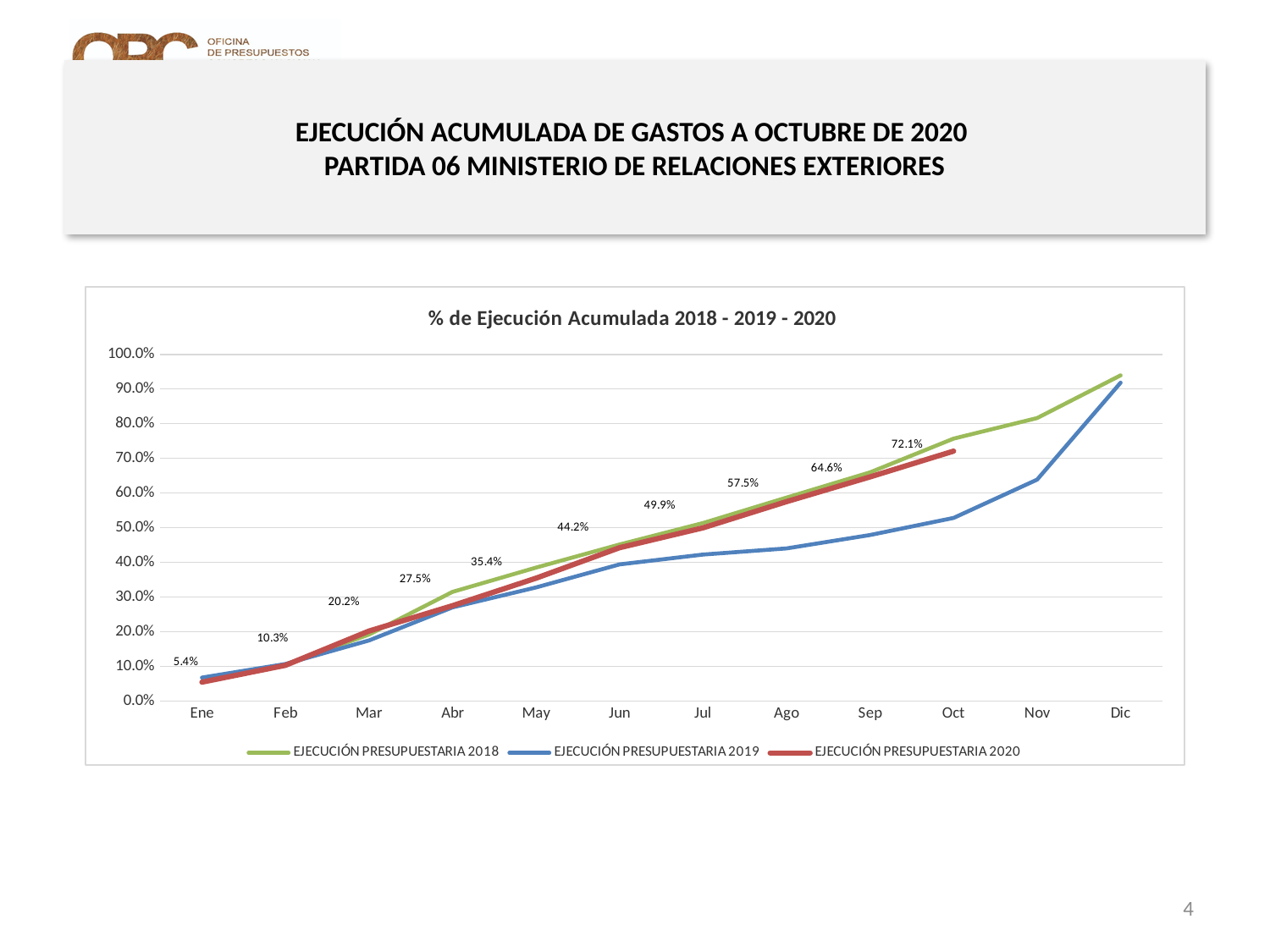
Is the value for EJECUCIÓN PRESUPUESTARIA 2019 in Oct greater or less than 60.0%? less What is the value for EJECUCIÓN PRESUPUESTARIA 2020 in Oct? 72.1% What is the value for EJECUCIÓN PRESUPUESTARIA 2020 in Jun? 44.2% What kind of chart is shown on the slide? line chart How many series does the chart legend list? 3 Which series has the higher value in Nov, EJECUCIÓN PRESUPUESTARIA 2018 or EJECUCIÓN PRESUPUESTARIA 2019? EJECUCIÓN PRESUPUESTARIA 2018 What is the value for EJECUCIÓN PRESUPUESTARIA 2020 in Ene? 5.4% How many months are shown on the x axis of the chart? 12 What is the difference between the EJECUCIÓN PRESUPUESTARIA 2020 values for Sep and Ago? 7.1% Does the EJECUCIÓN PRESUPUESTARIA 2020 line rise or fall from Ene to Oct? rise What is the title of the chart? % de Ejecución Acumulada 2018 - 2019 - 2020 In which month does the EJECUCIÓN PRESUPUESTARIA 2020 series reach its highest labelled value? Oct